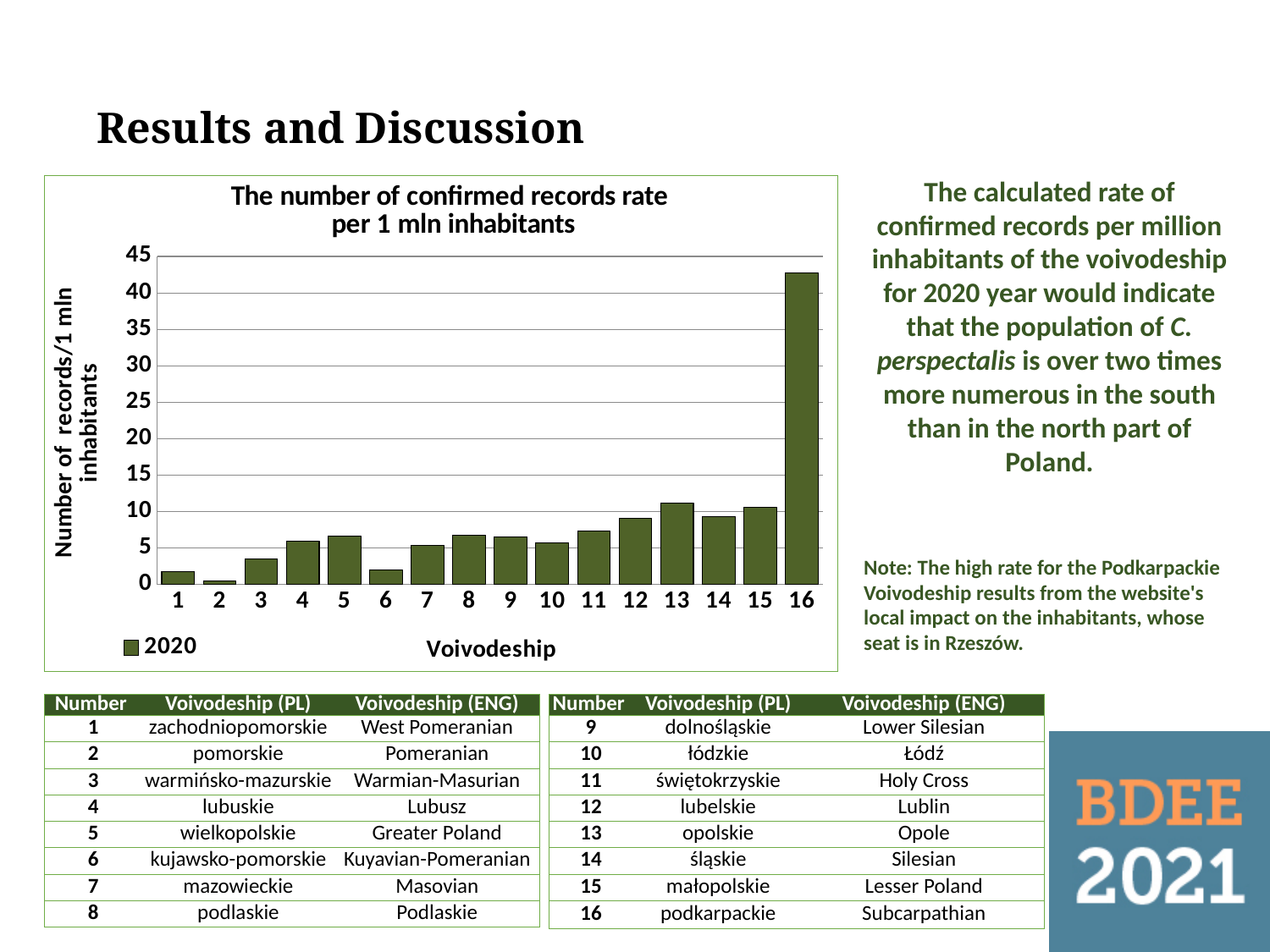
Which has a higher value, voivodeship 16 or voivodeship 13? 16 Which voivodeship number has the highest number of records per 1 mln inhabitants? 16 Is the value for voivodeship 13 greater or less than 10? greater Is the value for voivodeship 16 greater or less than 40? greater What year does the legend entry show? 2020 Is the value for voivodeship 12 greater or less than 10? less Which has a higher value, voivodeship 3 or voivodeship 6? 3 Which voivodeship number has the lowest number of records per 1 mln inhabitants? 2 How many series does the legend list? 1 How many voivodeships are plotted on the x axis? 16 What kind of chart is shown on the slide? bar chart